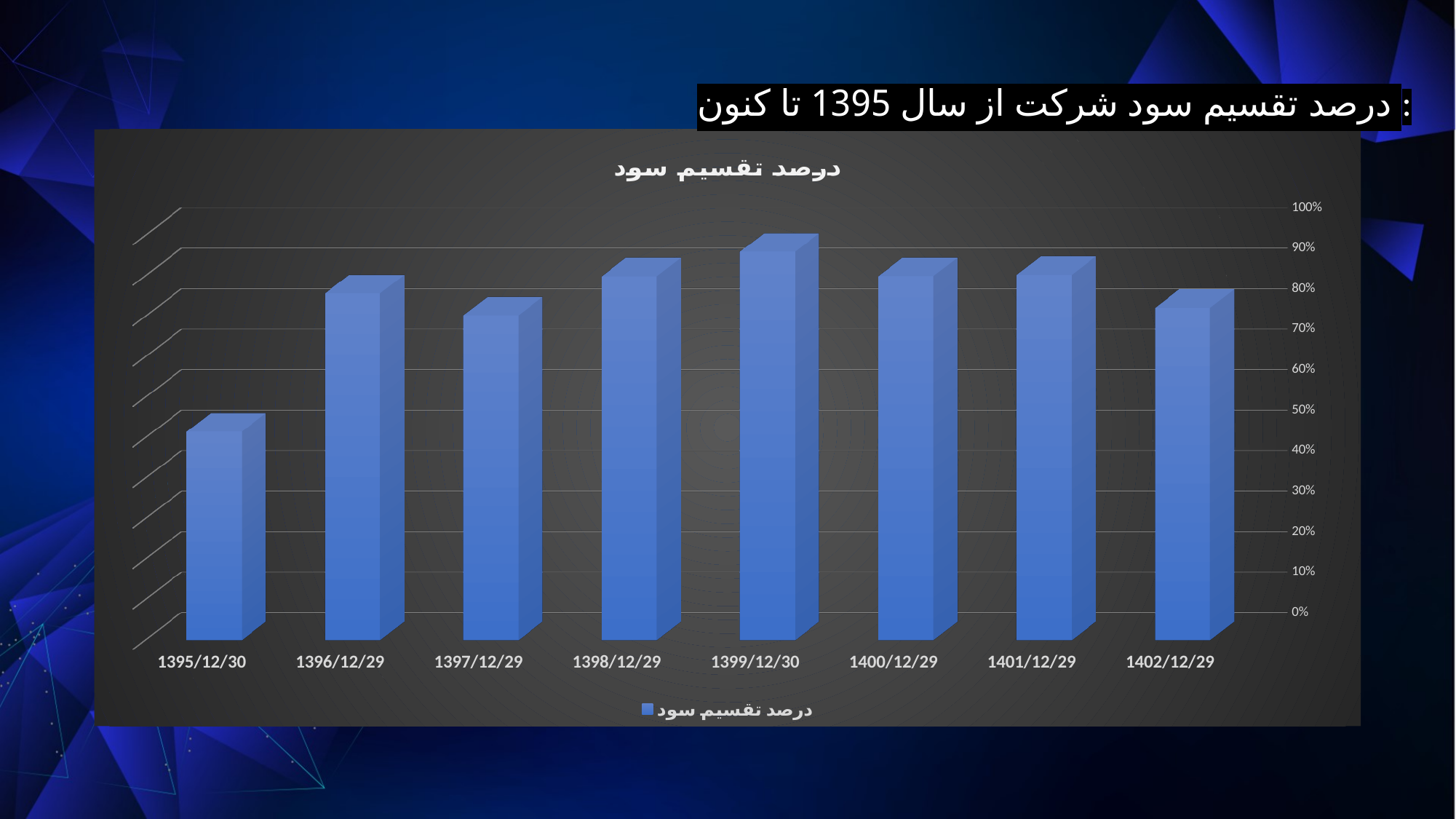
Is the value for 1399/12/30 greater or less than 80%? greater Is the value for 1397/12/29 greater or less than 60%? greater What kind of chart is shown on the slide? bar chart How many categories (dates) are shown on the x axis of the chart? 8 Which is larger, the value for 1395/12/30 or the value for 1396/12/29? 1396/12/29 Which date has the lowest value in the chart? 1395/12/30 Which date has the highest value in the chart? 1399/12/30 How many series does the chart's legend list? 1 Which is larger, the value for 1397/12/29 or the value for 1398/12/29? 1398/12/29 What is the title of the chart? درصد تقسیم سود Is the value for 1402/12/29 greater or less than 60%? greater